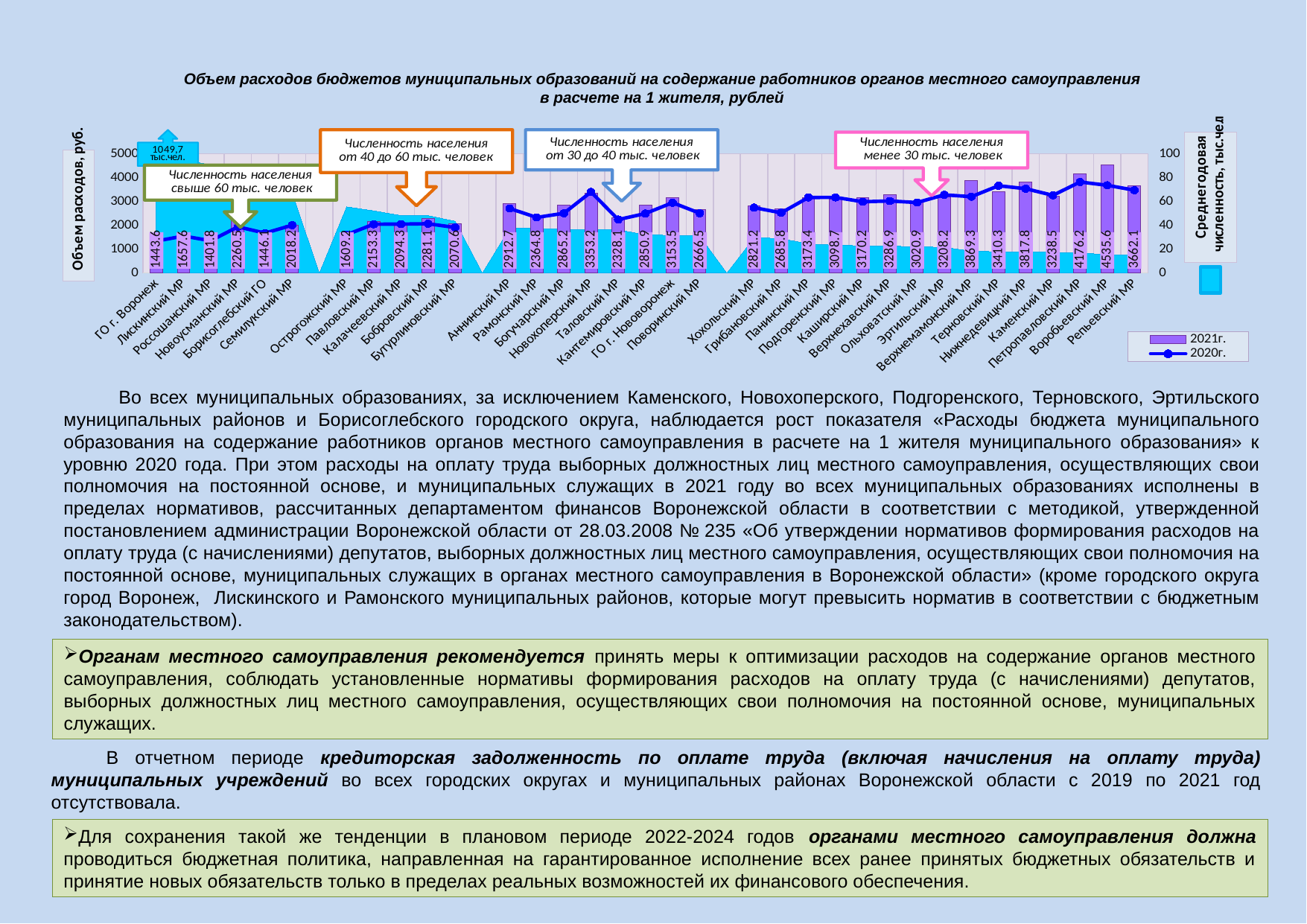
What is the 2021 value for ГО г. Воронеж? 1443.6 What is the 2021 value for Воробьевский МР? 4535.6 What is the difference between the 2021 values for Новоусманский МР and ГО г. Воронеж? 816.9 What is the 2021 value for Новохоперский МР? 3353.2 Which municipality has the highest 2021 value? Воробьевский МР Is the 2020 value for Новохоперский МР greater or less than 3000? greater Which municipality has the lowest 2021 value? Россошанский МР How many series does the legend list? 2 Which has the larger 2021 value, Аннинский МР or Рамонский МР? Аннинский МР What is the 2021 value for Бобровский МР? 2281.1 What is the difference between the 2021 values for Воробьевский МР and Петропавловский МР? 359.4 Which population group does the pink callout label the last group of municipalities as? Численность населения менее 30 тыс. человек